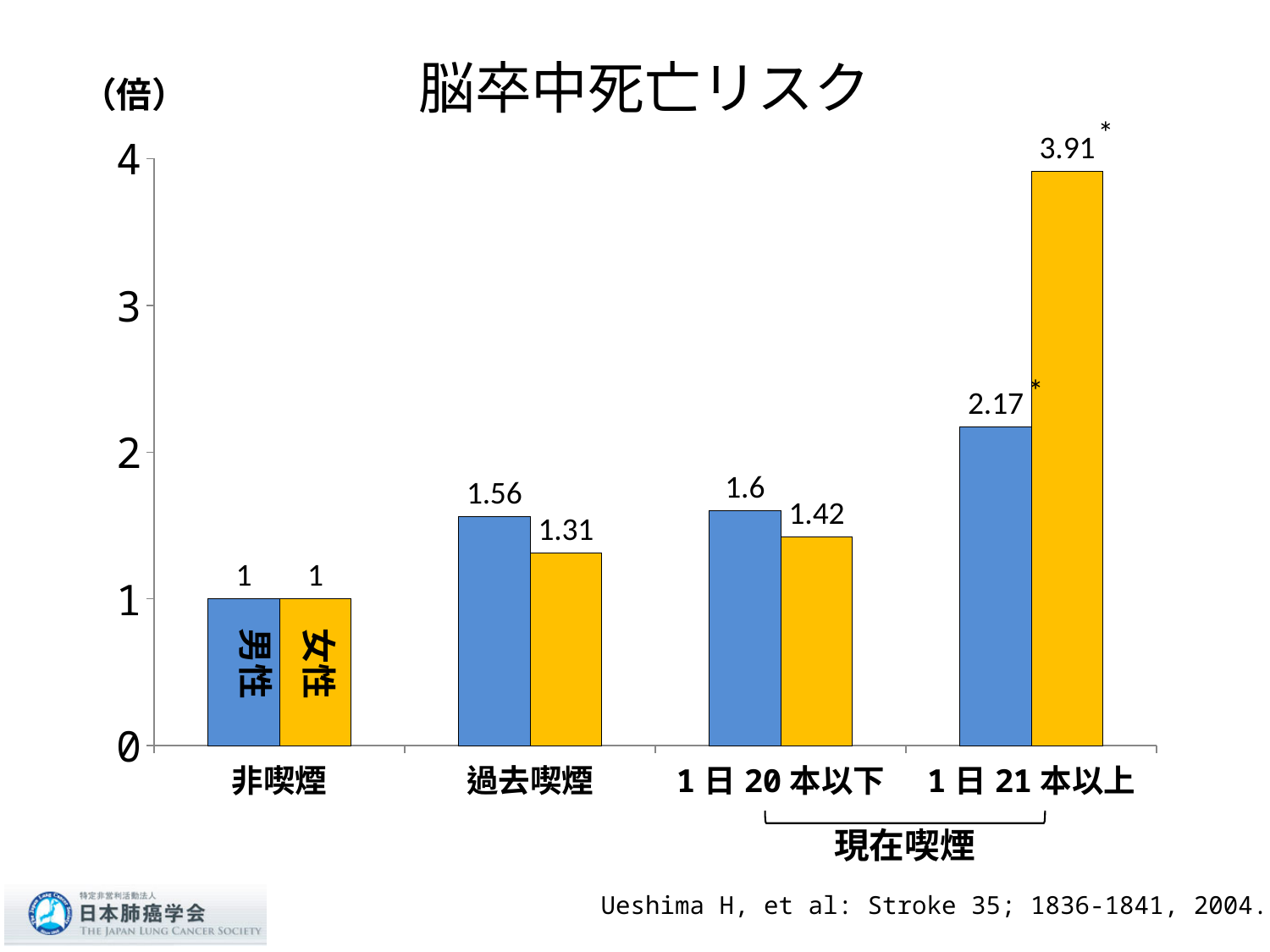
What is the value for 男性 in the 1日21本以上 category? 2.17 What is the value for 女性 in the 1日20本以下 category? 1.42 Which category has the lowest value for 男性? 非喫煙 How many series does the chart show? 2 In the 過去喫煙 category, which is larger, the 男性 value or the 女性 value? 男性 What kind of chart is this? bar chart Which category has the highest value for 女性? 1日21本以上 What is the value for 女性 in the 1日21本以上 category? 3.91 What is the title of the chart? 脳卒中死亡リスク How many categories are shown on the x axis? 4 What is the difference between the 女性 and 男性 values in the 1日21本以上 category? 1.74 What is the value for 男性 in the 過去喫煙 category? 1.56